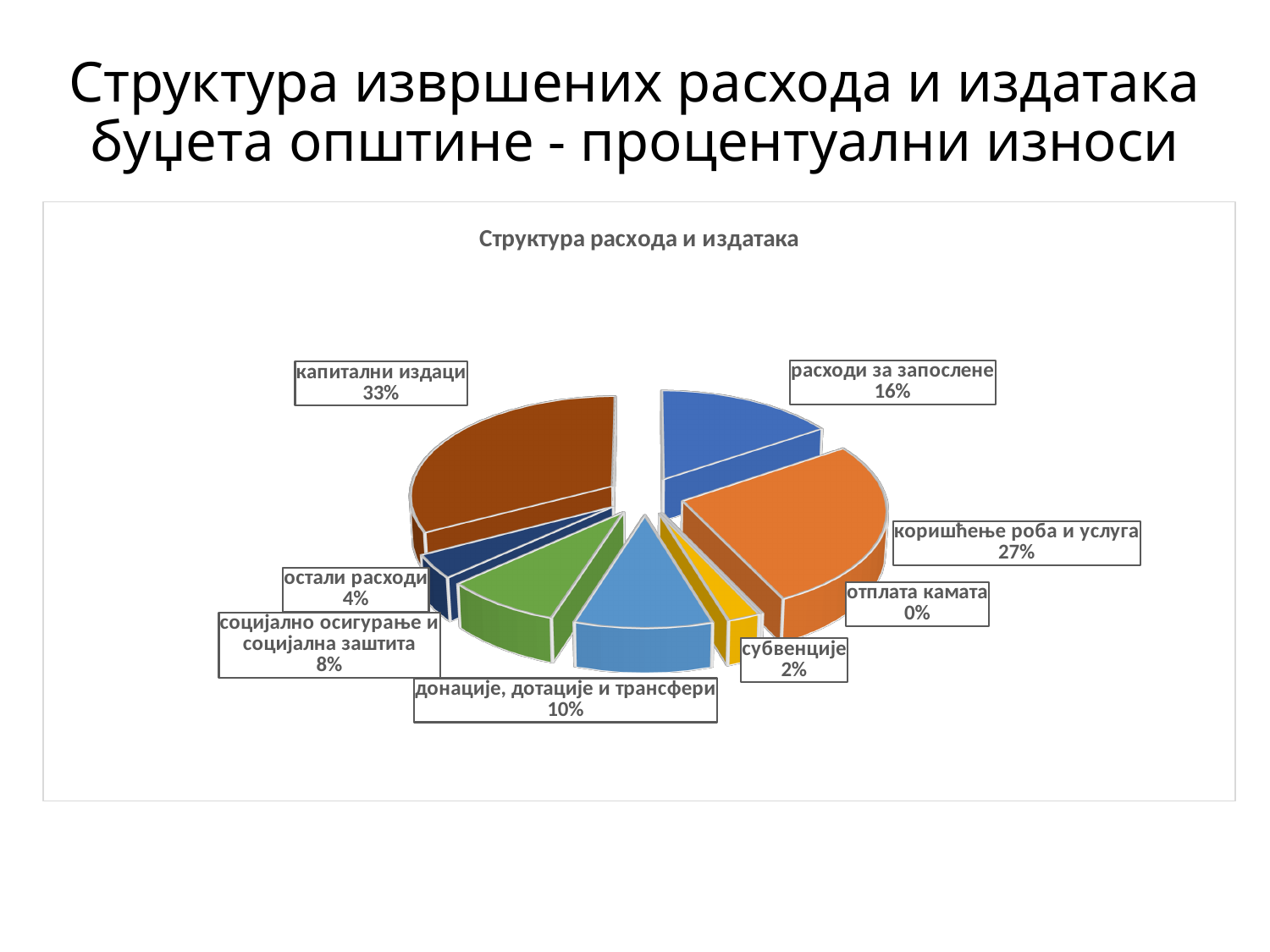
What percentage is shown for социјално осигурање и социјална заштита? 8% Which category has the largest share of the pie? капитални издаци Which category has the smallest share of the pie? отплата камата What percentage is shown for коришћење роба и услуга? 27% What share of the pie is капитални издаци? 33% What percentage is shown for донације, дотације и трансфери? 10% Which is larger, the share for субвенције or the share for остали расходи? остали расходи What kind of chart is shown on the slide? Pie chart What percentage is shown for расходи за запослене? 16% What is the title of the chart? Структура расхода и издатака What is the difference in percentage points between капитални издаци and коришћење роба и услуга? 6 How many slices does the pie chart have? 8